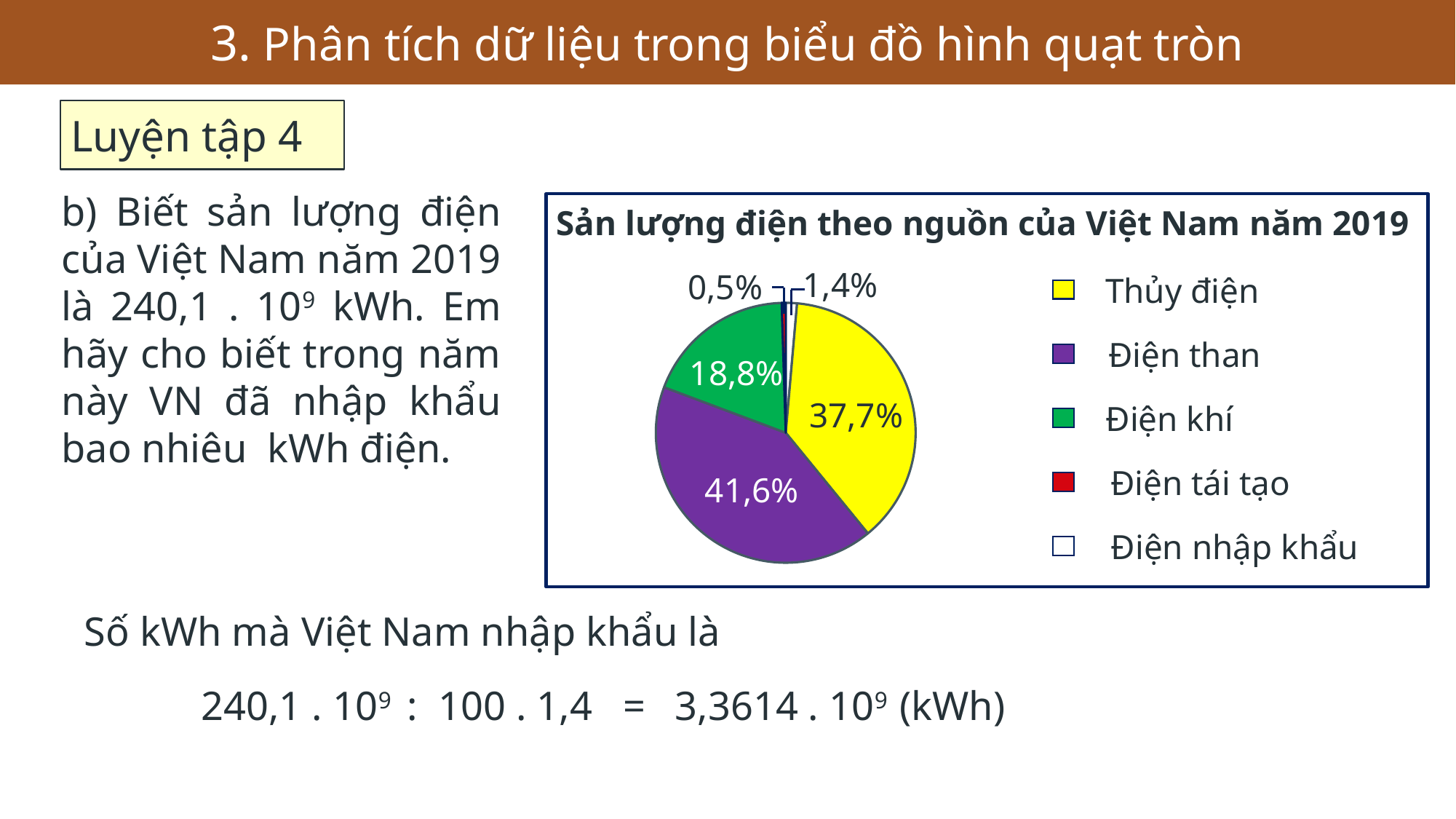
What is the title of the chart? Sản lượng điện theo nguồn của Việt Nam năm 2019 Which is larger, the share of Điện khí or the share of Thủy điện? Thủy điện What percentage of the pie does Điện than represent? 41,6% How many categories does the legend list? 5 Which source has the largest share of the pie? Điện than What percentage of the pie does Thủy điện represent? 37,7% What type of chart is shown on the slide? pie chart What is the difference between the shares of Điện than and Thủy điện? 3,9% What percentage of the pie does Điện khí represent? 18,8% What percentage of the pie does Điện tái tạo represent? 0,5% What percentage of the pie does Điện nhập khẩu represent? 1,4% Which source has the smallest share of the pie? Điện tái tạo